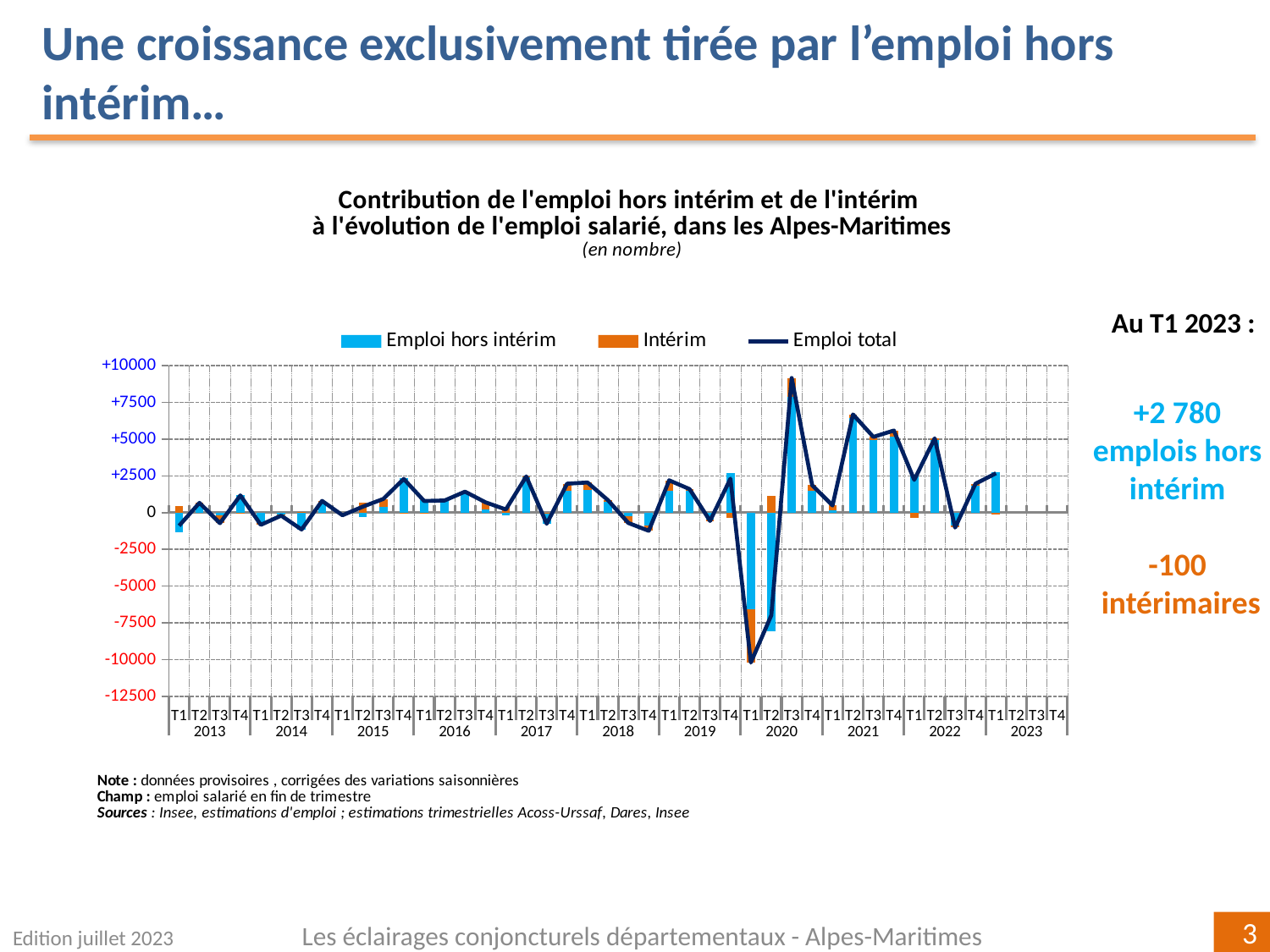
Which is larger, the Emploi hors intérim bar at T3 2020 or at T2 2021? T3 2020 Is the value of Emploi total at T3 2020 greater or less than 7500? greater In which quarter does Emploi total reach its highest value? T3 2020 How many years are labelled along the x axis? 11 What colour are the Intérim bars? Orange According to the slide, what is the value for Emploi hors intérim at T1 2023? +2 780 Is the value of Emploi total at T1 2020 greater or less than -7500? less In which quarter does Emploi total reach its lowest value? T1 2020 Which series is drawn as a line rather than bars? Emploi total According to the slide, what is the value for Intérim at T1 2023? -100 How many series does the chart legend list? 3 What kind of chart is shown on the slide? A combined bar and line chart